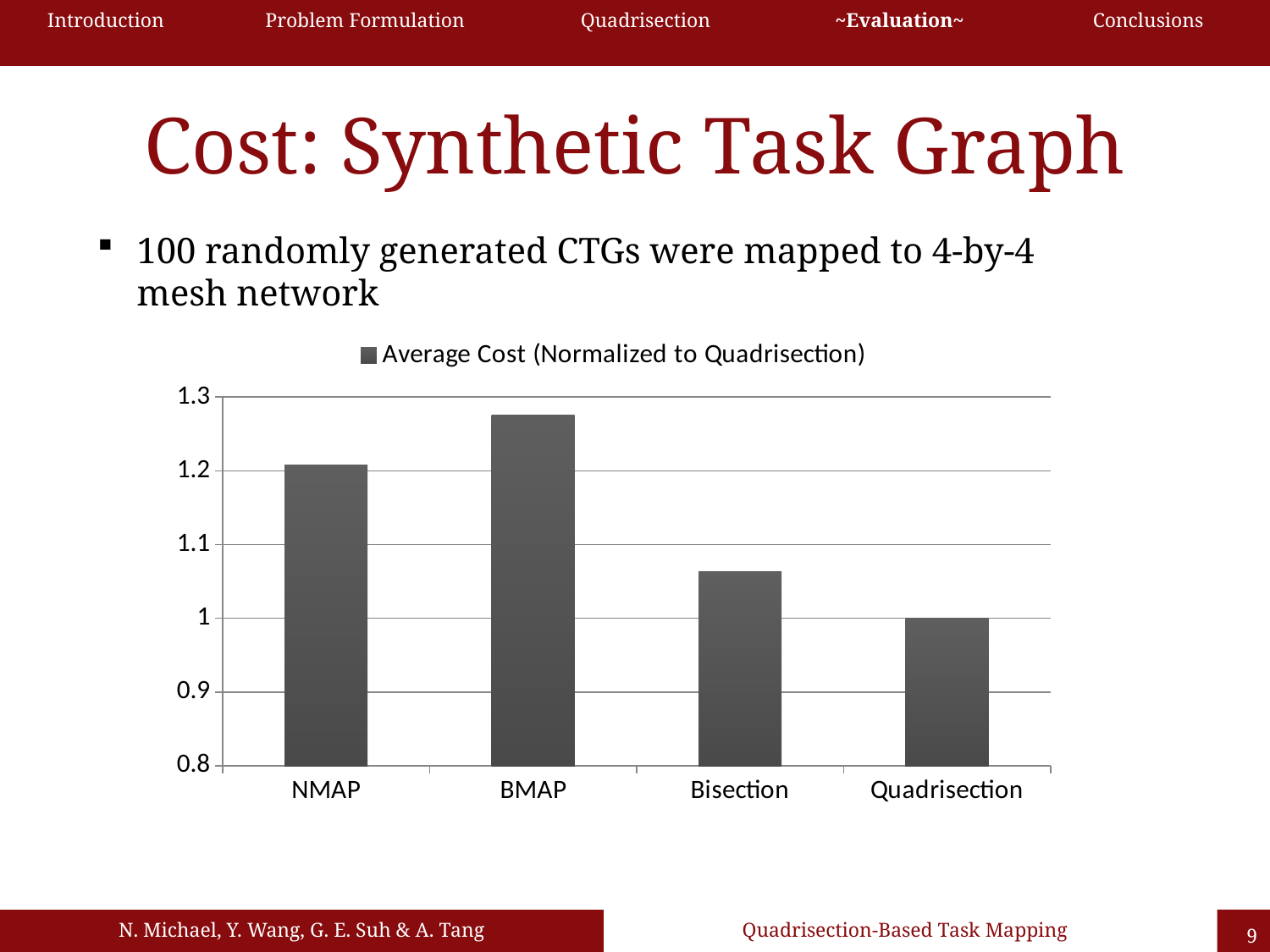
What kind of chart is shown on the slide? bar chart What is the average cost value for Quadrisection? 1 What is the legend entry of the series plotted in the chart? Average Cost (Normalized to Quadrisection) How many series does the chart legend list? 1 Which category has the lowest average cost in the chart? Quadrisection Is the value for Bisection greater or less than 1.1? less Is the value for BMAP greater or less than 1.2? greater Which category has the highest average cost in the chart? BMAP What is the lowest value shown on the y axis of the chart? 0.8 Is the value for NMAP greater or less than 1.1? greater How many categories are shown on the x axis of the chart? 4 Which has a larger average cost, NMAP or Bisection? NMAP